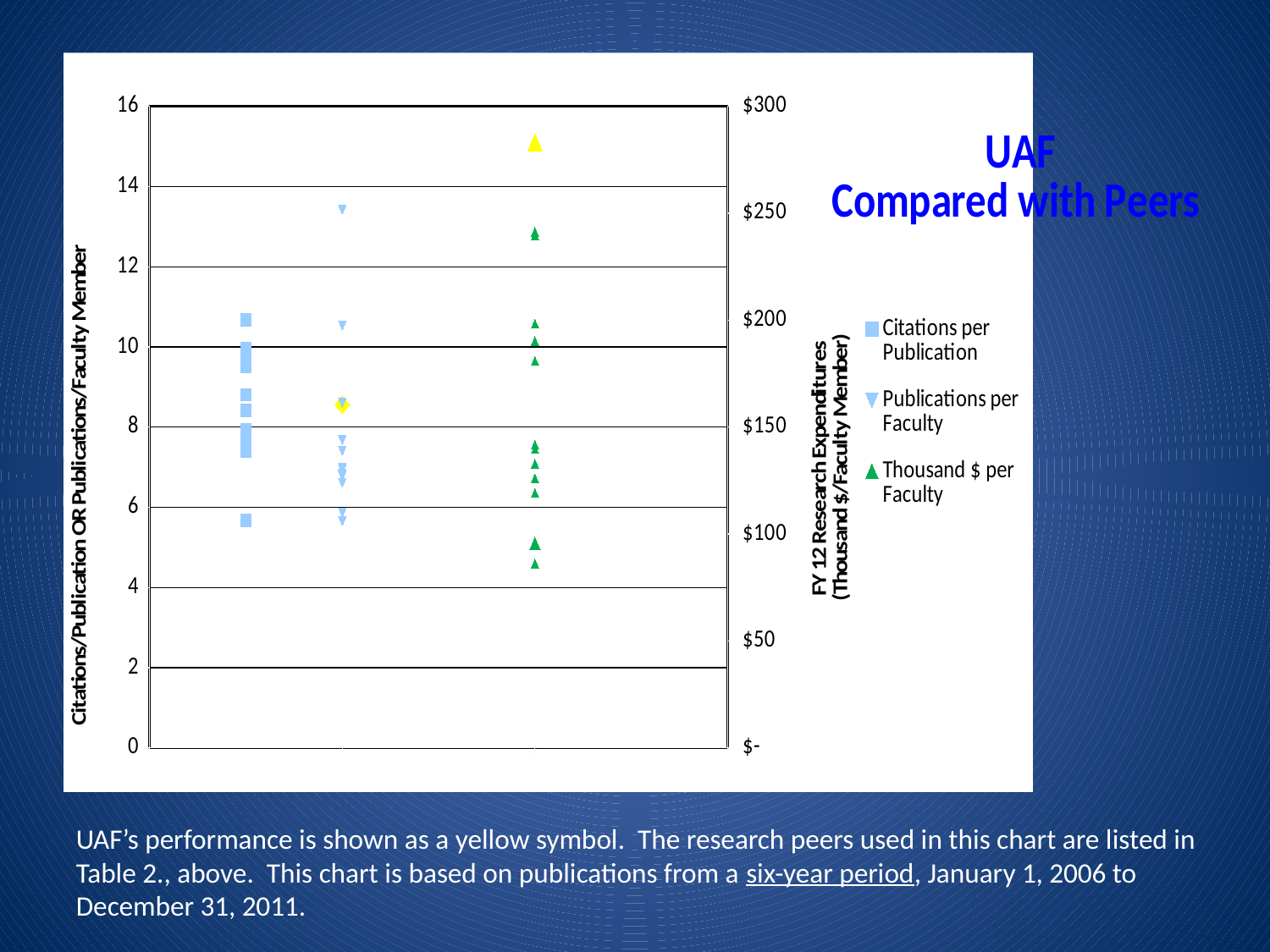
Is the highest Citations per Publication point greater or less than 10? greater Which institution has the highest Thousand $ per Faculty value on the chart? UAF What is the maximum value shown on the right-hand axis? $300 What is the title shown next to the chart? UAF Compared with Peers Is UAF's value for Thousand $ per Faculty (the yellow up-triangle) greater or less than $250? greater Is the lowest Citations per Publication point greater or less than 6? less What kind of chart is shown on the slide? Scatter plot How many series does the chart legend list? 3 Which colour marks UAF's performance on the chart? Yellow